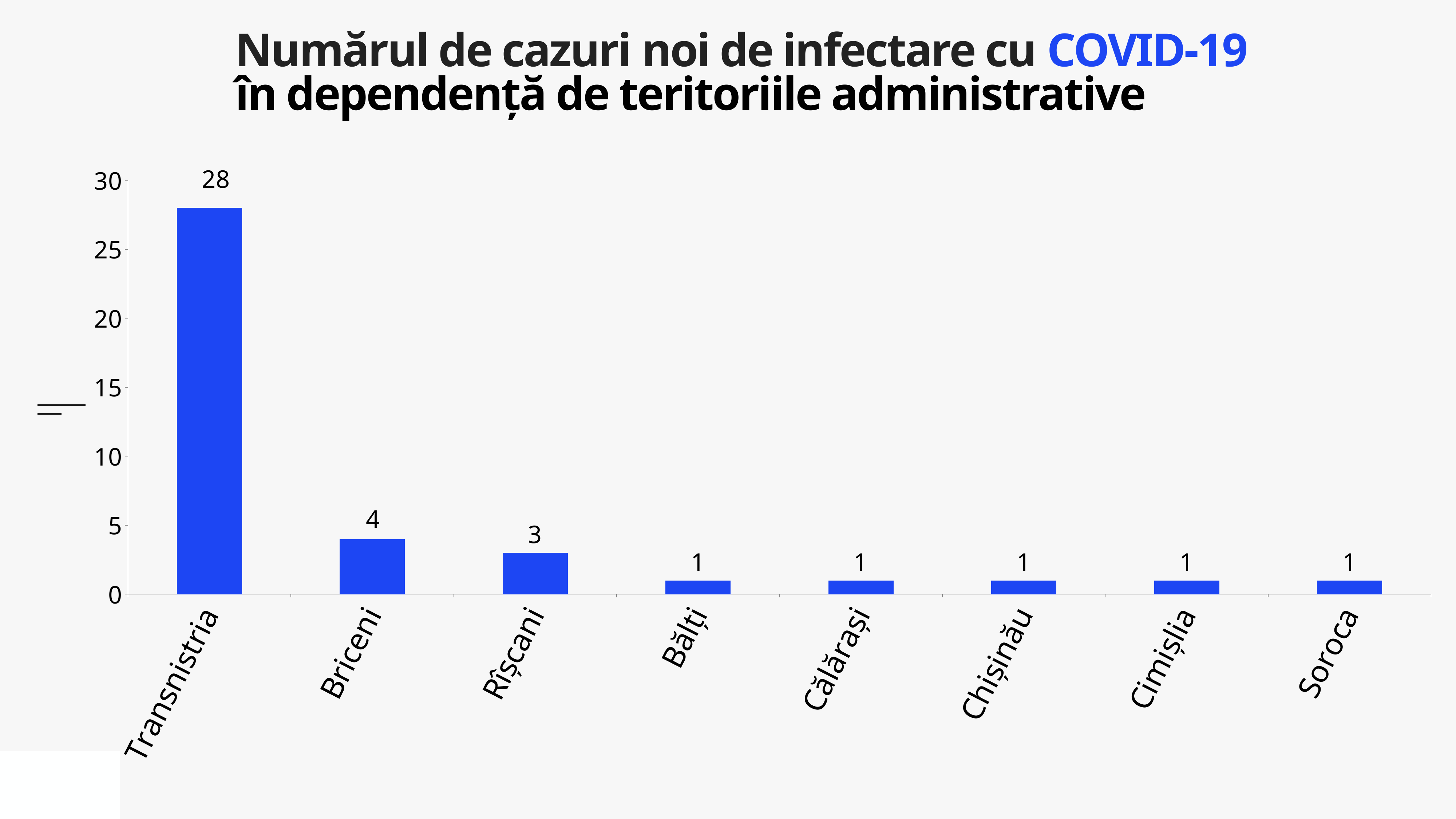
Which is larger, the value for Briceni or the value for Soroca? Briceni What kind of chart is shown on the slide? bar chart What is the value for Chișinău? 1 What is the value for Briceni? 4 Which category has the highest value? Transnistria How many categories are shown on the x axis? 8 What is the difference between the values for Briceni and Rîșcani? 1 What is the value for Rîșcani? 3 What is the difference between the values for Transnistria and Briceni? 24 What is the title of the chart? Numărul de cazuri noi de infectare cu COVID-19 în dependență de teritoriile administrative What is the value for Transnistria? 28 Is the value for Transnistria greater or less than 25? greater